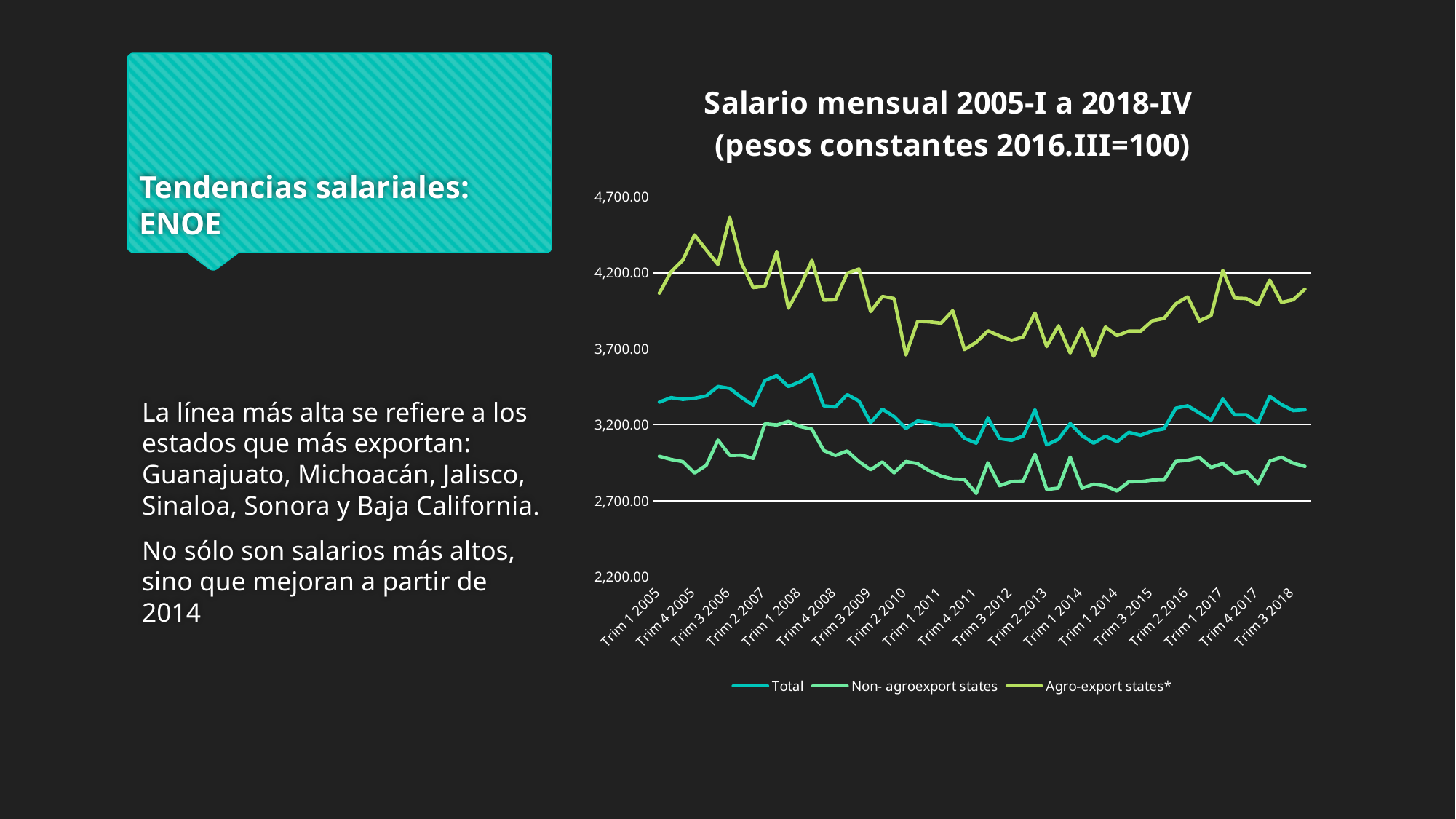
Is the value for Agro-export states* at Trim 3 2006 greater or less than 4,200? greater Is the value for Non- agroexport states at Trim 1 2005 greater or less than 3,200? less Is the value for Agro-export states* at Trim 1 2005 greater or less than 3,700? greater Which series is plotted lowest across the whole chart? Non- agroexport states Does the Agro-export states* line generally rise or fall from Trim 1 2014 to Trim 3 2018? rise How many series does the legend list? 3 Does the Agro-export states* line generally rise or fall from Trim 3 2006 to Trim 4 2011? fall Which series is plotted highest across the whole chart? Agro-export states* What kind of chart is shown on the slide? line chart What is the title of the chart? Salario mensual 2005-I a 2018-IV (pesos constantes 2016.III=100)